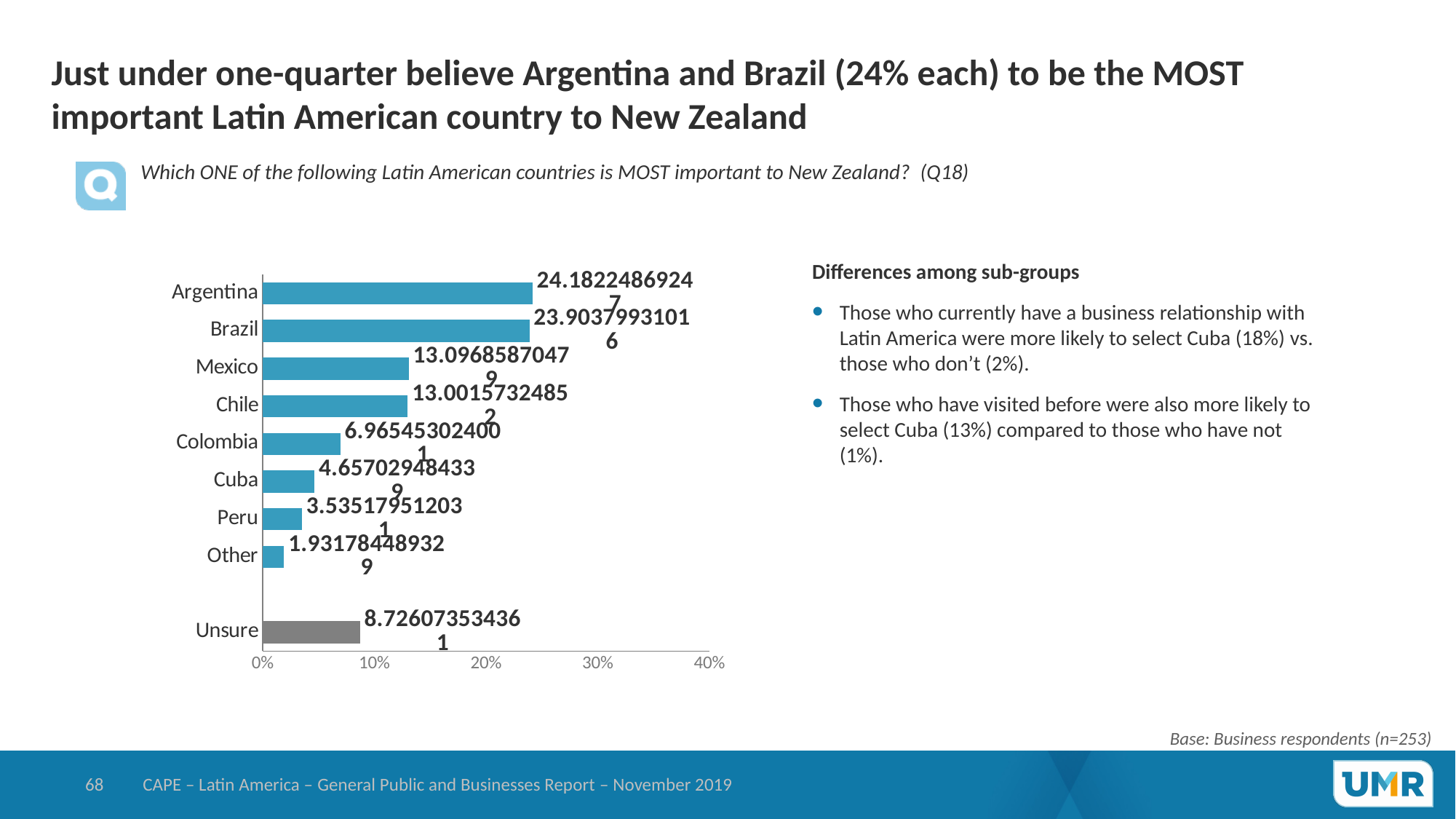
Which has the larger value, Mexico or Chile? Mexico Is the value for Brazil greater or less than 20%? greater What kind of chart is shown on the slide? bar chart What is the data label shown for Argentina? 24.18224869247 Which bar in the chart is coloured grey rather than blue? Unsure Which country has the highest value in the chart? Argentina Is the value for Cuba greater or less than 10%? less How many categories are plotted in the chart? 9 Which has the larger value, Argentina or Brazil? Argentina Is the value for Colombia greater or less than 10%? less What is the data label shown for Unsure? 8.726073534361 Which category has the lowest value in the chart? Other